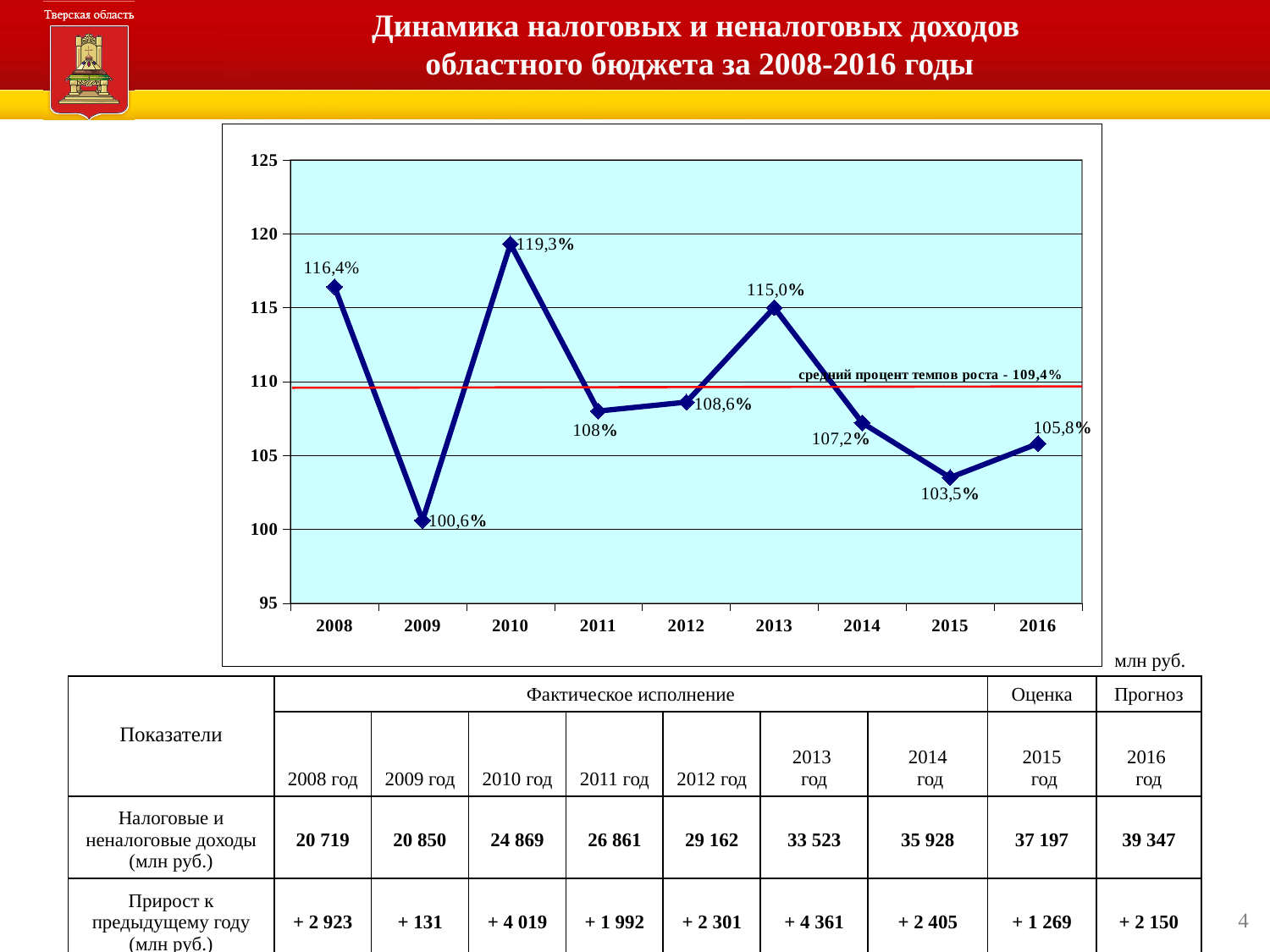
What is the value plotted for 2009? 100,6% What is the value plotted for 2016? 105,8% Which year has the lowest value on the chart? 2009 What average growth rate is indicated by the red horizontal line on the chart? 109,4% What is the value plotted for 2010? 119,3% What type of chart is shown on the slide? line chart Do the values rise or fall from 2013 to 2015? fall What is the difference between the values for 2010 and 2009? 18,7 percentage points How many years are plotted on the x axis of the chart? 9 Which is larger, the value for 2013 or the value for 2008? 2008 What is the value plotted for 2014? 107,2% Which year has the highest value on the chart? 2010